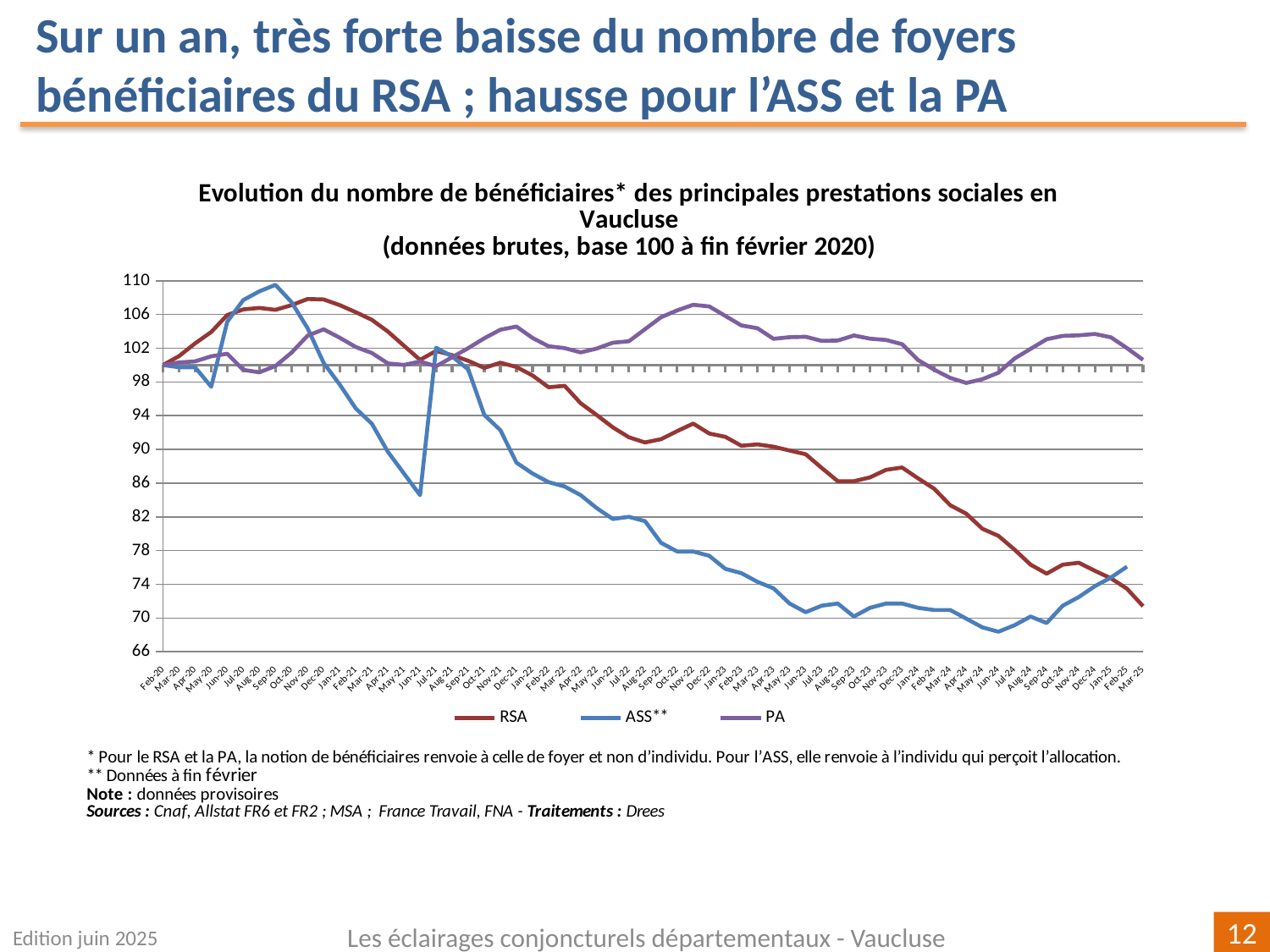
Is the value for ASS** at Jun-24 greater or less than 70? less What is the base value and reference date stated in the chart title? base 100 à fin février 2020 Is the value for PA at May-24 greater or less than 100? less How many series does the legend list? 3 What kind of chart is shown on the slide? line chart Is the value for RSA at Sep-24 greater or less than 78? less At Mar-25, which series has the higher value, PA or RSA? PA Which series are listed in the legend? RSA, ASS**, PA Does the RSA series overall rise or fall between Feb-20 and Mar-25? fall